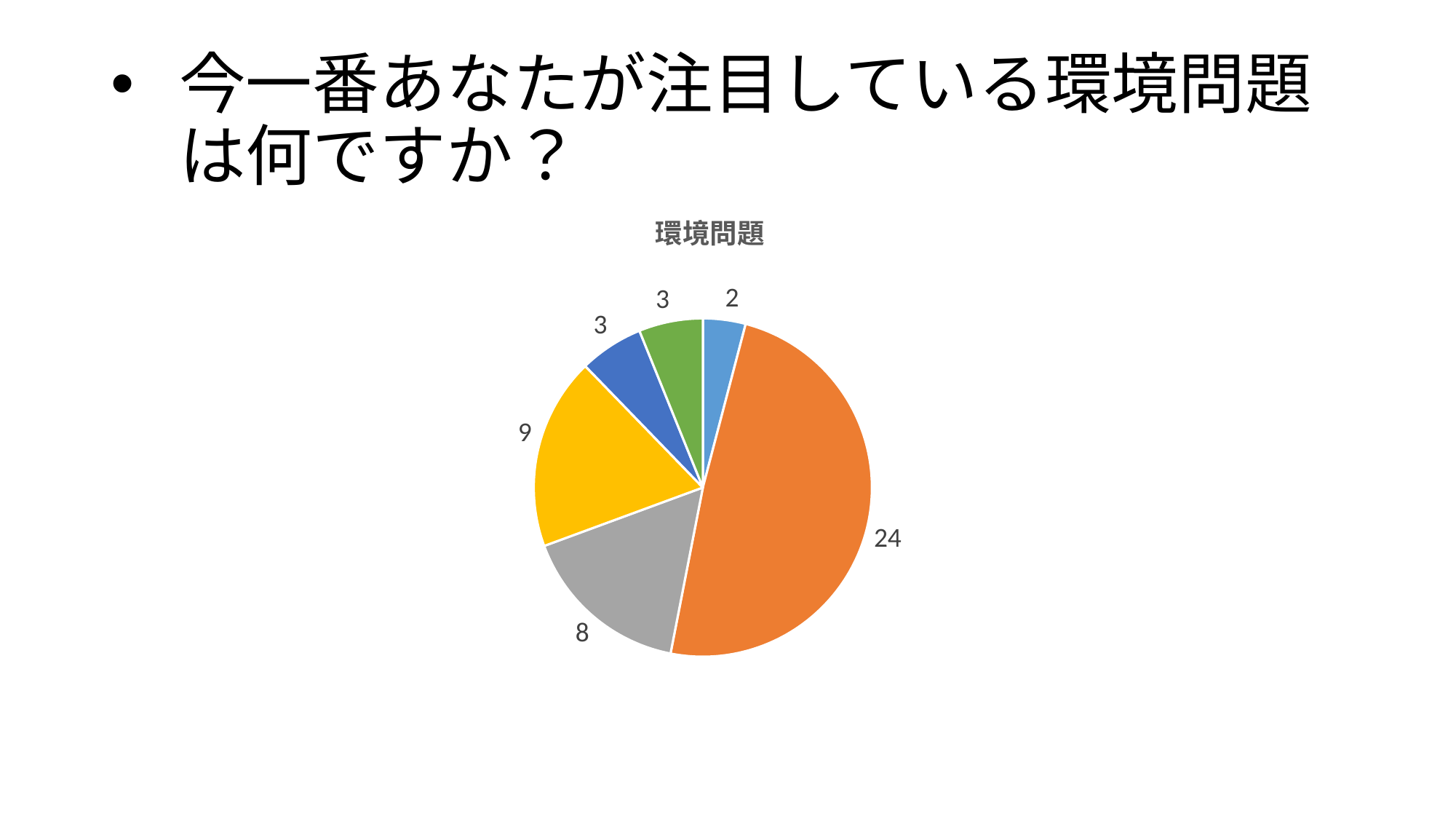
What is the value of the yellow slice? 9 What is the difference between the orange slice and the yellow slice? 15 What is the value of the smallest slice? 2 Which is larger, the yellow slice or the gray slice? Yellow slice What is the value of the largest slice? 24 What is the value of the orange slice? 24 What is the total of all slice values in the pie chart? 49 What is the value of the gray slice? 8 What is the value of the light blue slice? 2 What is the title of the chart? 環境問題 How many slices does the pie chart have? 6 What kind of chart is shown on the slide? Pie chart